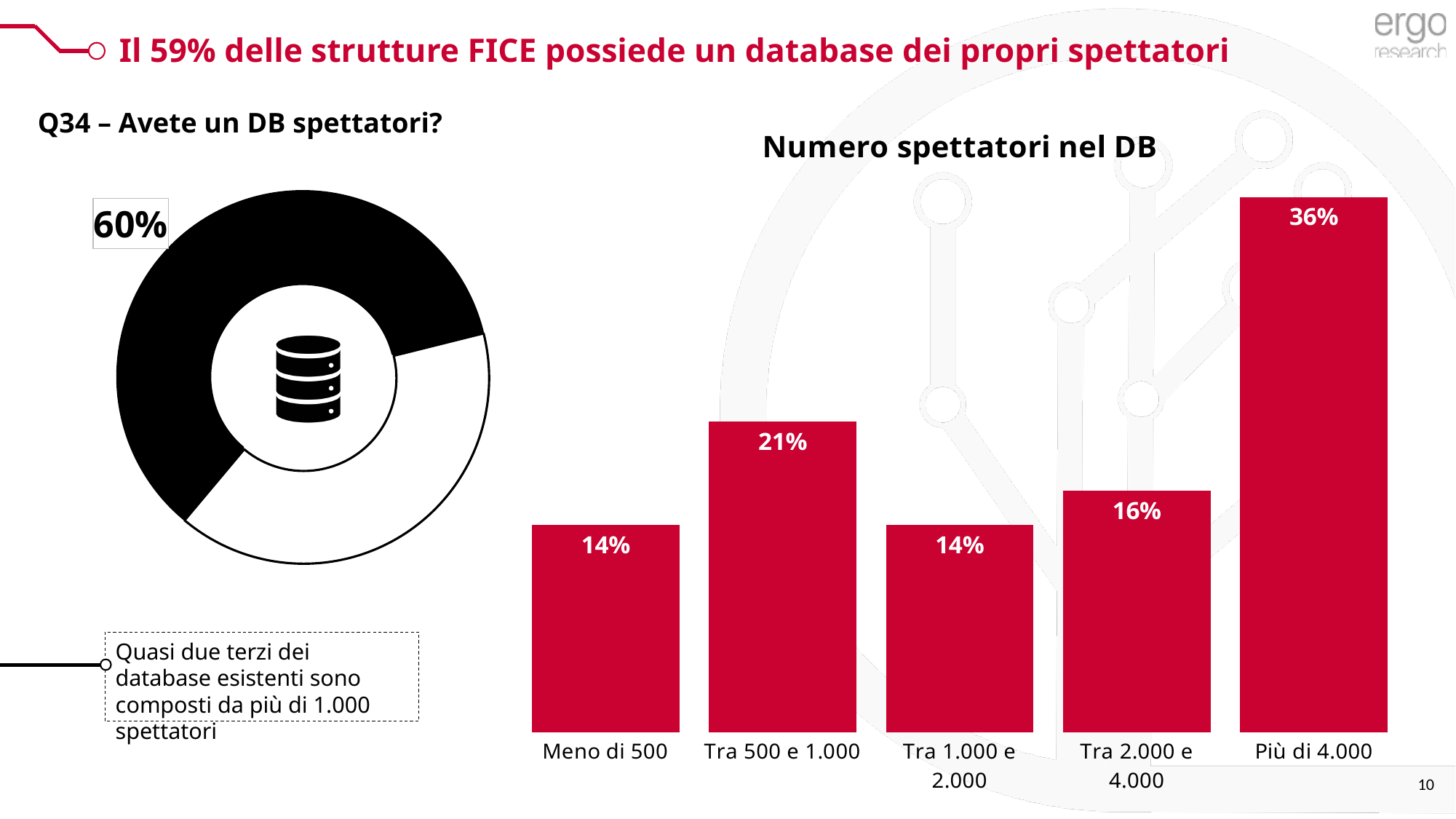
In the 'Numero spettatori nel DB' chart, what is the value for 'Tra 2.000 e 4.000'? 16% In the 'Numero spettatori nel DB' chart, which category has the highest value? Più di 4.000 What is the title of the bar chart on the right of the slide? Numero spettatori nel DB In the 'Numero spettatori nel DB' chart, what is the difference between 'Tra 2.000 e 4.000' and 'Meno di 500'? 2% What kind of chart is 'Numero spettatori nel DB'? Bar chart In the 'Numero spettatori nel DB' chart, which is larger: 'Tra 500 e 1.000' or 'Tra 2.000 e 4.000'? Tra 500 e 1.000 In the 'Numero spettatori nel DB' chart, what is the difference between 'Più di 4.000' and 'Tra 500 e 1.000'? 15% What kind of chart is shown on the left of the slide under 'Q34 – Avete un DB spettatori?'? Donut chart What percentage is labelled on the donut chart on the left of the slide? 60% How many categories are shown in the 'Numero spettatori nel DB' chart? 5 In the 'Numero spettatori nel DB' chart, what is the value for 'Più di 4.000'? 36% In the 'Numero spettatori nel DB' chart, what is the value for 'Tra 500 e 1.000'? 21%